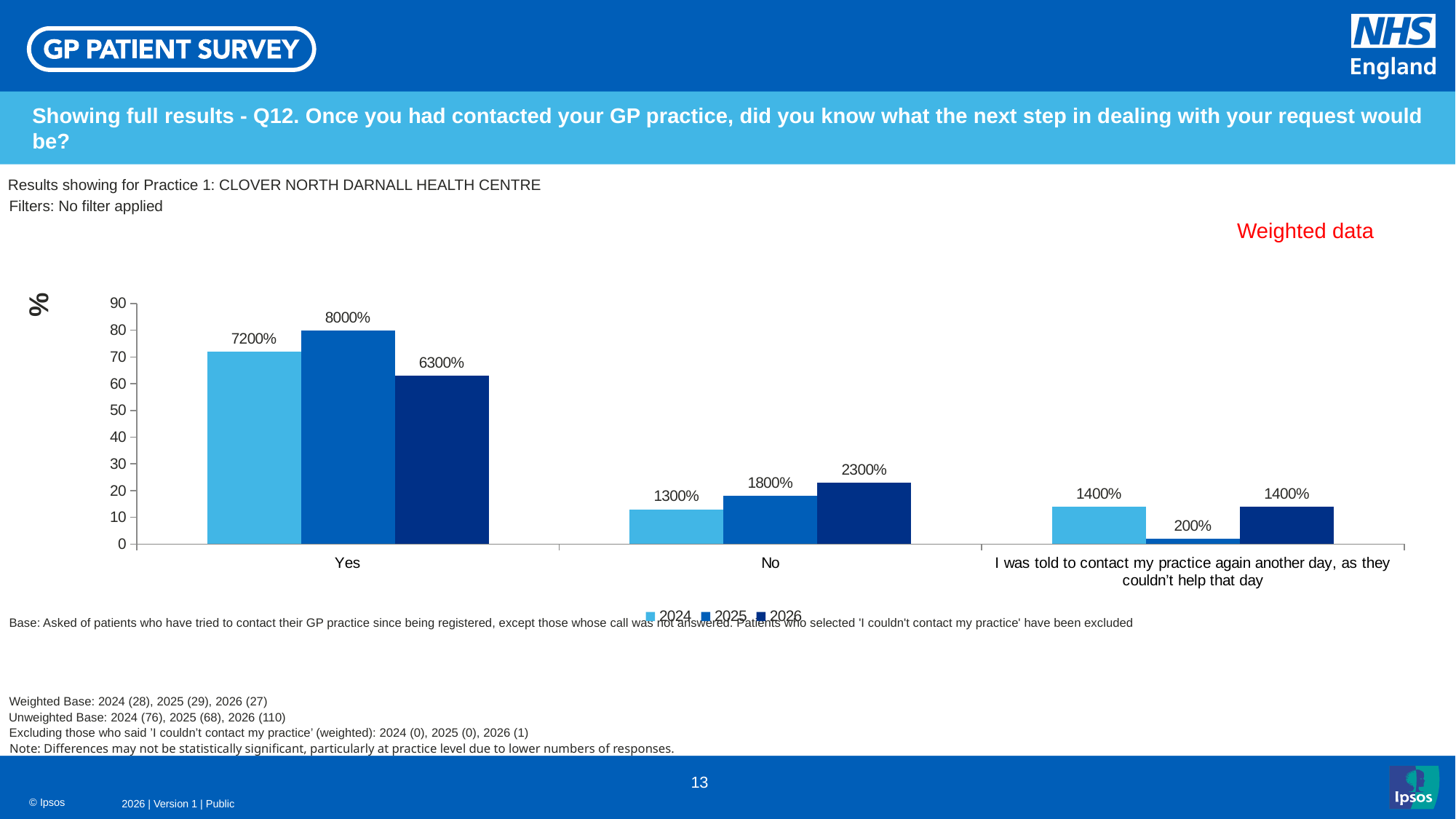
What is the difference between the 2025 and 2024 values in the 'Yes' category? 800% What kind of chart is shown on the slide? Bar chart How many series does the legend list? 3 Which practice are the results shown for? Practice 1: CLOVER NORTH DARNALL HEALTH CENTRE How many response categories are shown on the x axis? 3 Which is larger in the 'No' category: the 2024 value or the 2026 value? 2026 Which year has the lowest value in the 'I was told to contact my practice again another day, as they couldn't help that day' category? 2025 Do the values for the 'No' category rise or fall from 2024 to 2026? Rise What is the value for 2025 in the 'I was told to contact my practice again another day, as they couldn't help that day' category? 200% What is the value for 2025 in the 'Yes' category? 8000% What is the value for 2026 in the 'No' category? 2300% Which year has the highest value in the 'Yes' category? 2025